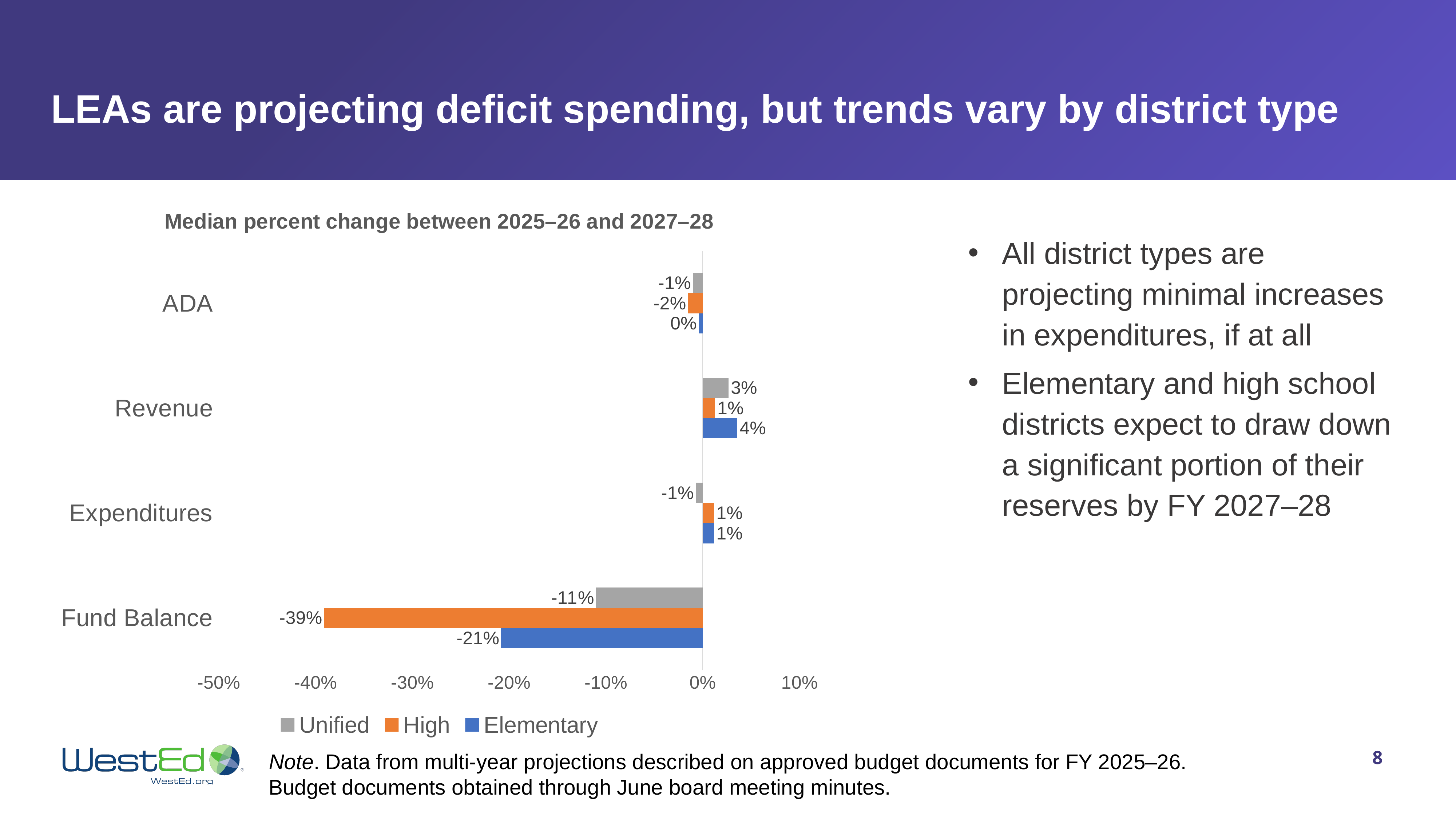
Which district type shows the highest median percent change in Revenue? Elementary What is the difference between the Fund Balance values for Elementary (-21%) and Unified (-11%) districts? 10 percentage points How many series does the legend list? 3 What type of chart is shown on the slide? Bar chart Which district type shows the lowest (most negative) median percent change in Fund Balance? High What is the median percent change in Fund Balance for High school districts? -39% What is the median percent change in ADA for High school districts? -2% What is the median percent change in Revenue for Elementary districts? 4% What is the median percent change in Expenditures for Unified districts? -1% How many categories are shown on the chart's vertical axis? 4 What is the title of the chart? Median percent change between 2025–26 and 2027–28 Which is larger in magnitude: the Fund Balance decline for Elementary districts or for Unified districts? Elementary